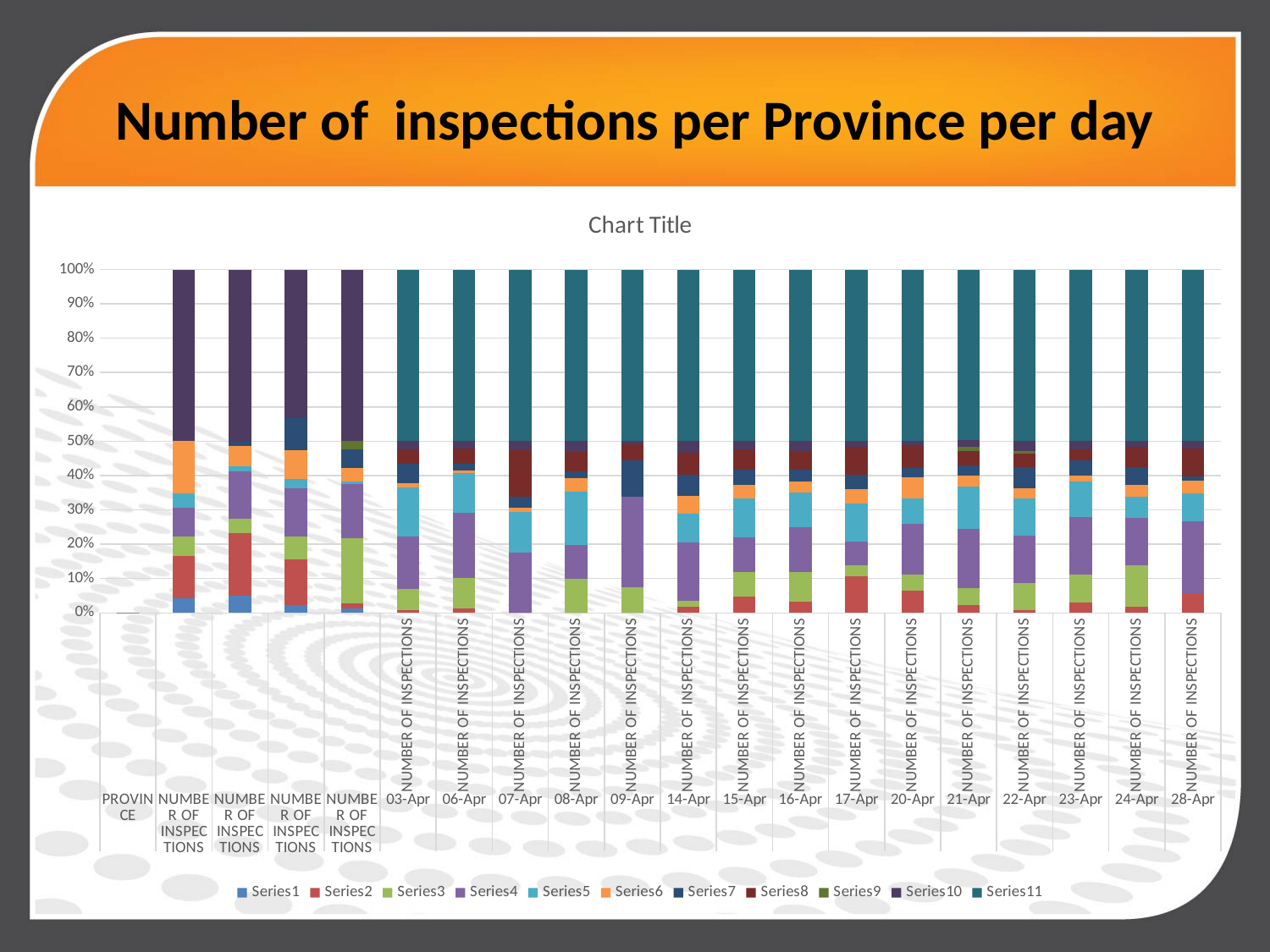
What is the highest value shown on the y axis? 100% What is the first date category shown on the x axis? 03-Apr How many series does the legend list? 11 What is the last series name listed in the legend? Series11 What is the title printed above the chart area? Chart Title What kind of chart is shown on the slide? Stacked bar chart What is the total height of the stacked bar for 03-Apr, as read from the y axis? 100% What is the total height of the stacked bar for 28-Apr, as read from the y axis? 100% How many dated categories (e.g. 03-Apr, 06-Apr) are shown on the x axis? 15 What is the last date category shown on the x axis? 28-Apr